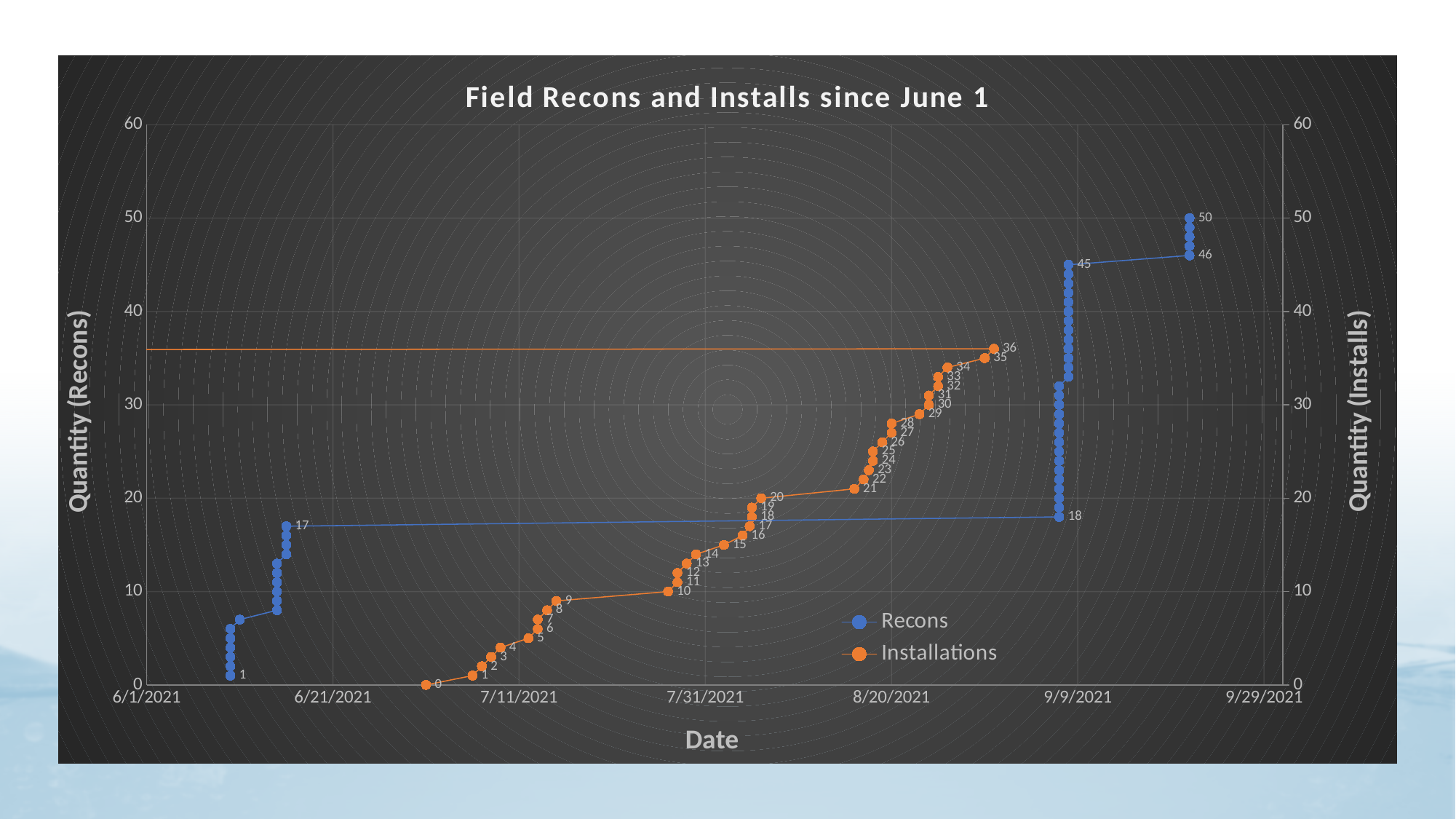
What kind of chart is shown on the slide? line chart Do the Recons values rise or fall as the date increases? rise What is the highest labelled value reached by the Recons series? 50 What is the title of the chart? Field Recons and Installs since June 1 How many series does the legend list? 2 What is the highest labelled value reached by the Installations series? 36 What is the difference between the Recons data labels 46 and 45? 1 What is the lowest labelled value of the Installations series? 0 Is the highest Installations value greater or less than 40? less Which series reaches a higher final value, Recons or Installations? Recons What is the title of the right-hand vertical axis? Quantity (Installs) What is the difference between the final Recons value (50) and the final Installations value (36)? 14